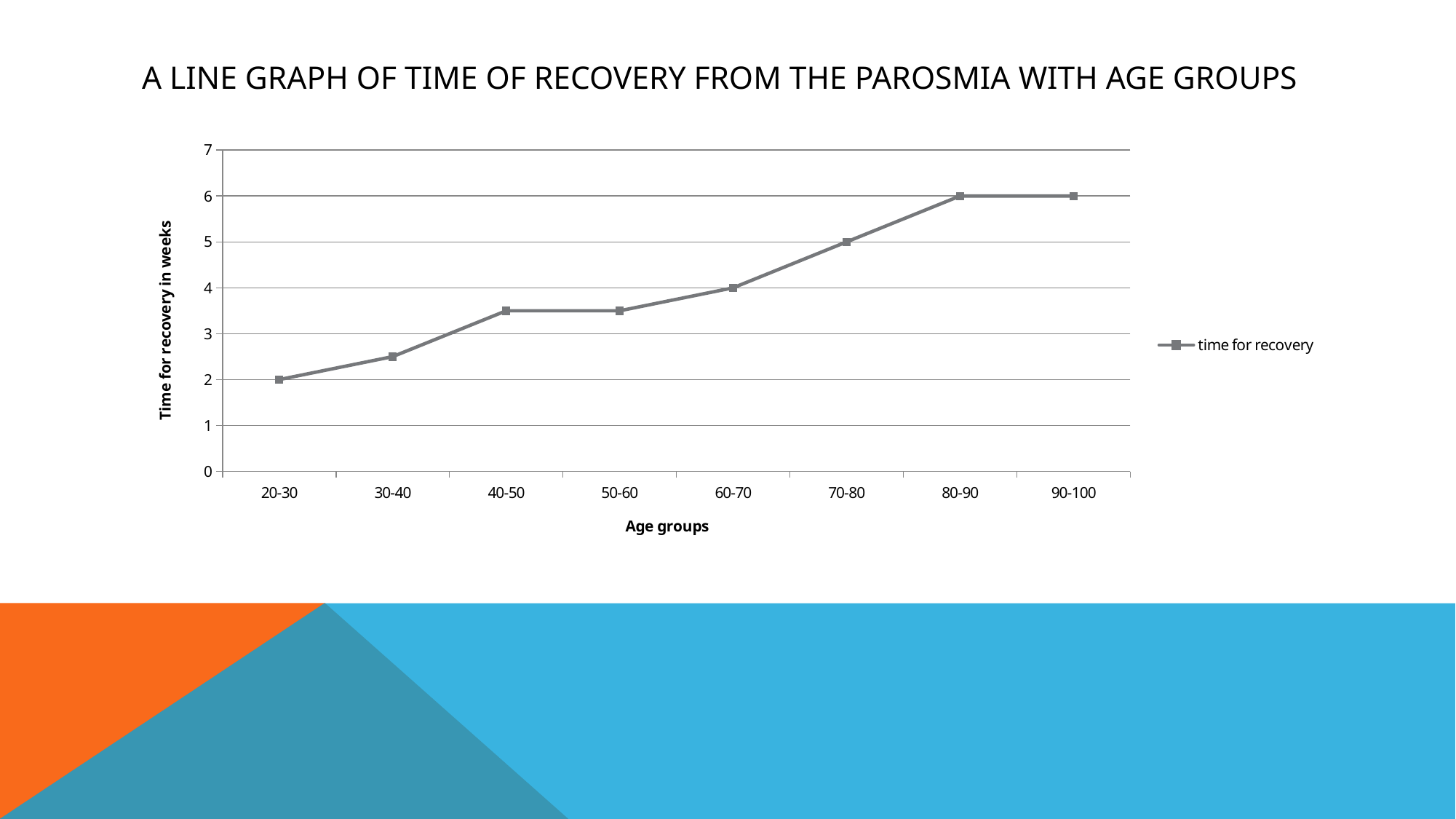
Does the time for recovery generally rise or fall as age group increases? rise What is the time for recovery for the 60-70 age group? 4 What is the time for recovery for the 20-30 age group? 2 Which has a higher time for recovery, the 70-80 age group or the 60-70 age group? 70-80 What kind of chart is shown on the slide? line chart Is the time for recovery for the 40-50 age group greater or less than 3? greater Is the time for recovery for the 30-40 age group greater or less than 3? less How many age groups are plotted on the x axis? 8 What is the time for recovery for the 70-80 age group? 5 What is the difference in time for recovery between the 70-80 and 20-30 age groups? 3 Which age group has the lowest time for recovery? 20-30 What is the time for recovery for the 80-90 age group? 6